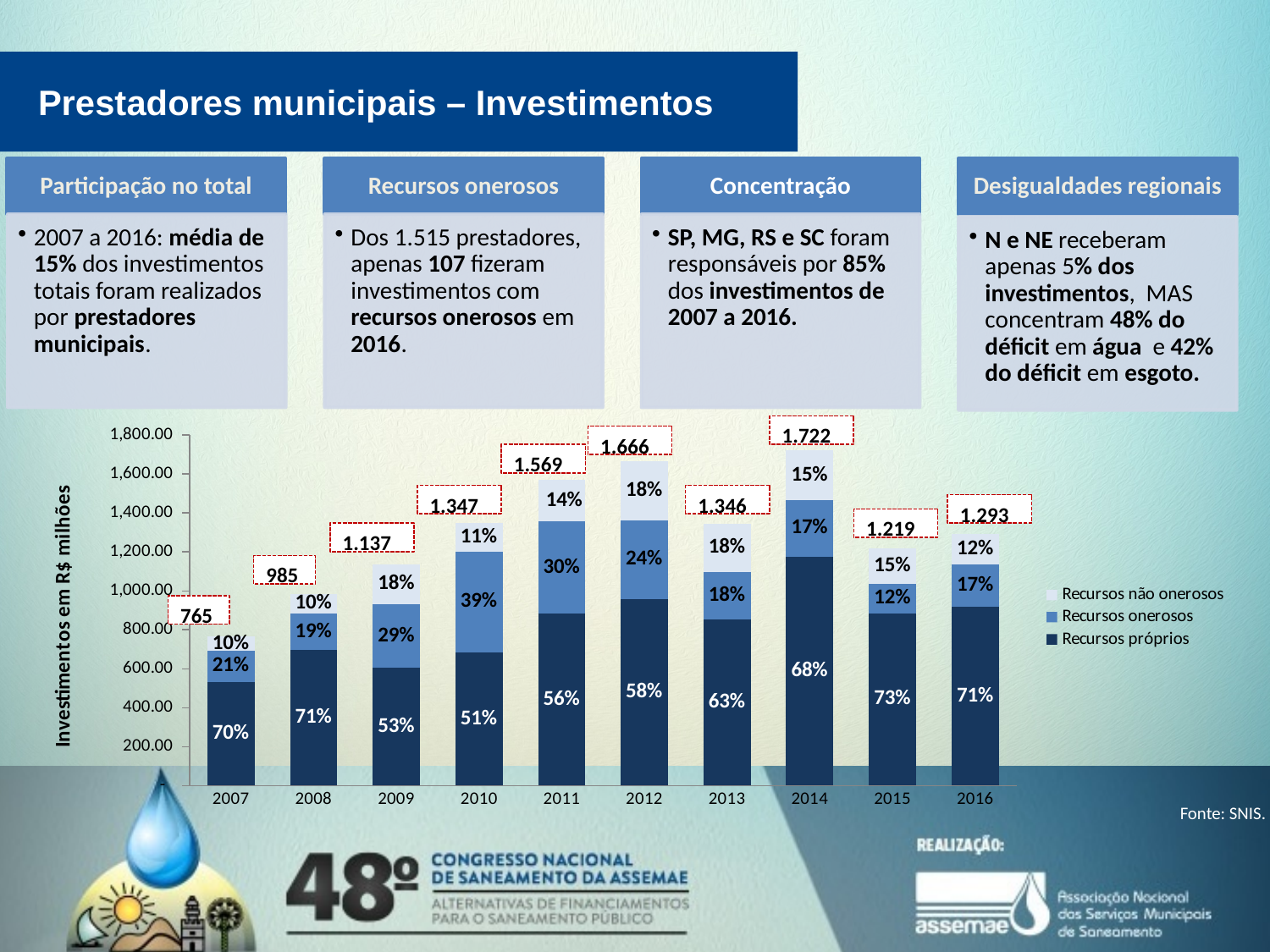
What is the total investment label shown for 2014? 1.722 What percentage of the 2015 bar is Recursos próprios? 73% How many years are shown on the x axis of the chart? 10 What percentage of the 2010 bar is Recursos onerosos? 39% What is the y-axis label of the chart? Investimentos em R$ milhões Which year has the lowest total investment? 2007 How many series does the chart legend list? 3 What is the difference between the total investment labels for 2012 and 2013? 320 Which year has the highest total investment? 2014 Which year has a larger total investment, 2011 or 2015? 2011 What kind of chart is shown on the slide? Stacked bar chart Is the total investment for 2008 greater or less than 1,000.00? less